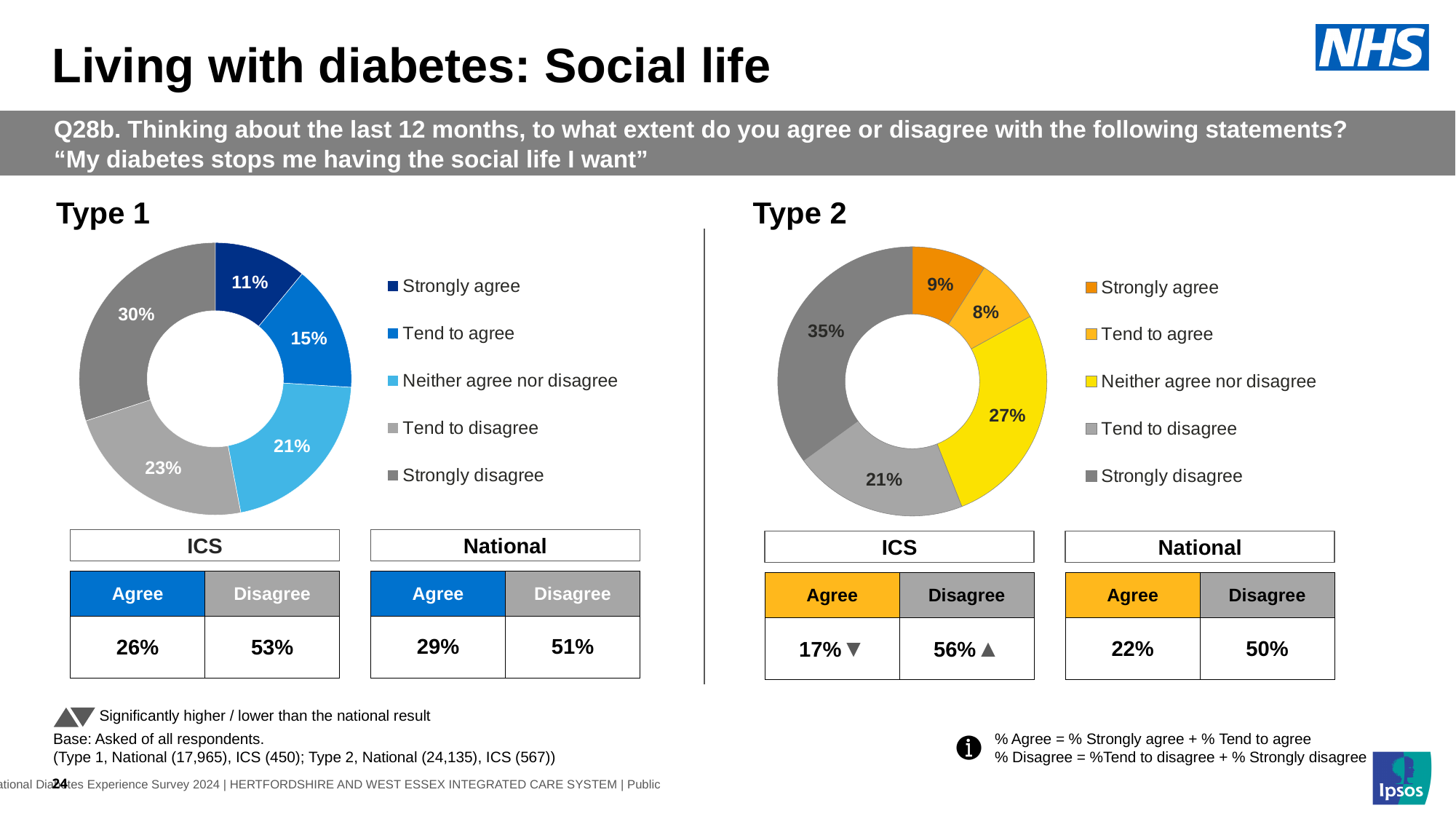
In the Type 1 chart, what is the combined share of 'Strongly agree' and 'Tend to agree'? 26% In the Type 1 chart, what percentage of respondents said 'Strongly disagree'? 30% In the Type 1 chart, what percentage of respondents said 'Neither agree nor disagree'? 21% In the Type 2 chart, which response category has the smallest share? Tend to agree What colour represents 'Neither agree nor disagree' in the Type 2 chart? Yellow How many response categories does the Type 1 chart's legend list? 5 In the Type 2 chart, what is the combined share of 'Tend to disagree' and 'Strongly disagree'? 56% In the Type 1 chart, what is the difference between the 'Tend to disagree' and 'Tend to agree' percentages? 8 percentage points In the Type 2 chart, what percentage of respondents said 'Neither agree nor disagree'? 27% What kind of chart is used to show the Type 2 results? Doughnut chart In the Type 2 chart, which is larger: 'Strongly agree' or 'Tend to agree'? Strongly agree In the Type 1 chart, which response category has the largest share? Strongly disagree